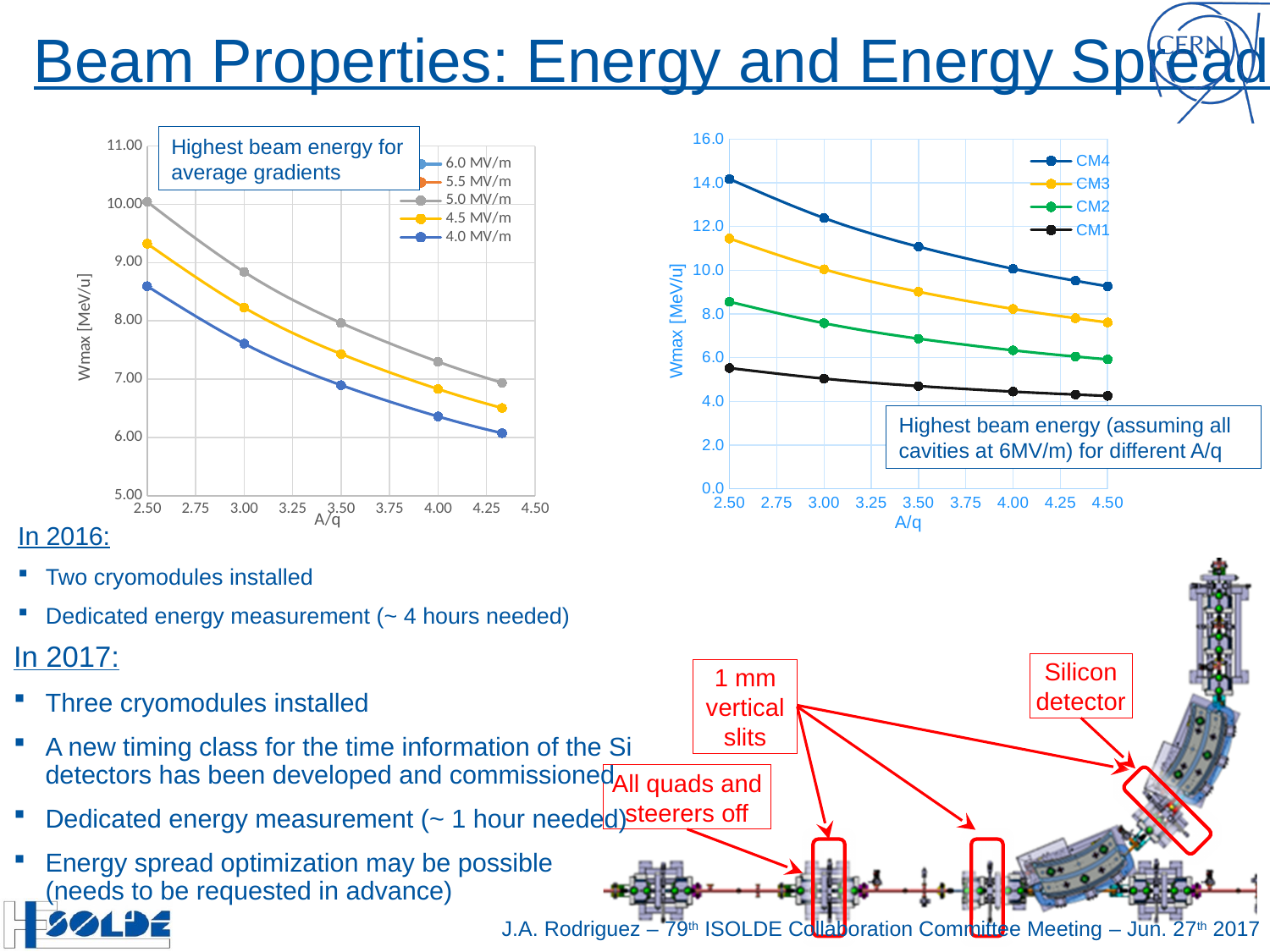
In the right chart (CM1 to CM4), which series has the lowest values? CM1 In the left chart (Highest beam energy for average gradients), is the value of the 4.0 MV/m series at A/q = 4.00 greater or less than 7.00? less In the right chart (CM1 to CM4), do the values rise or fall as A/q increases? fall How many series does the legend of the left chart (Highest beam energy for average gradients) list? 5 In the left chart (Highest beam energy for average gradients), is the value of the 5.0 MV/m series at A/q = 2.50 greater or less than 9.00? greater In the right chart (CM1 to CM4), at A/q = 3.00, which is larger: CM3 or CM2? CM3 What is the y-axis label of the right chart (CM1 to CM4)? Wmax [MeV/u] In the right chart (CM1 to CM4), is the value of CM4 at A/q = 2.50 greater or less than 12.0? greater What kind of chart is the left chart (Highest beam energy for average gradients)? line chart How many series does the legend of the right chart (CM1 to CM4) list? 4 In the right chart (CM1 to CM4), which series has the highest values? CM4